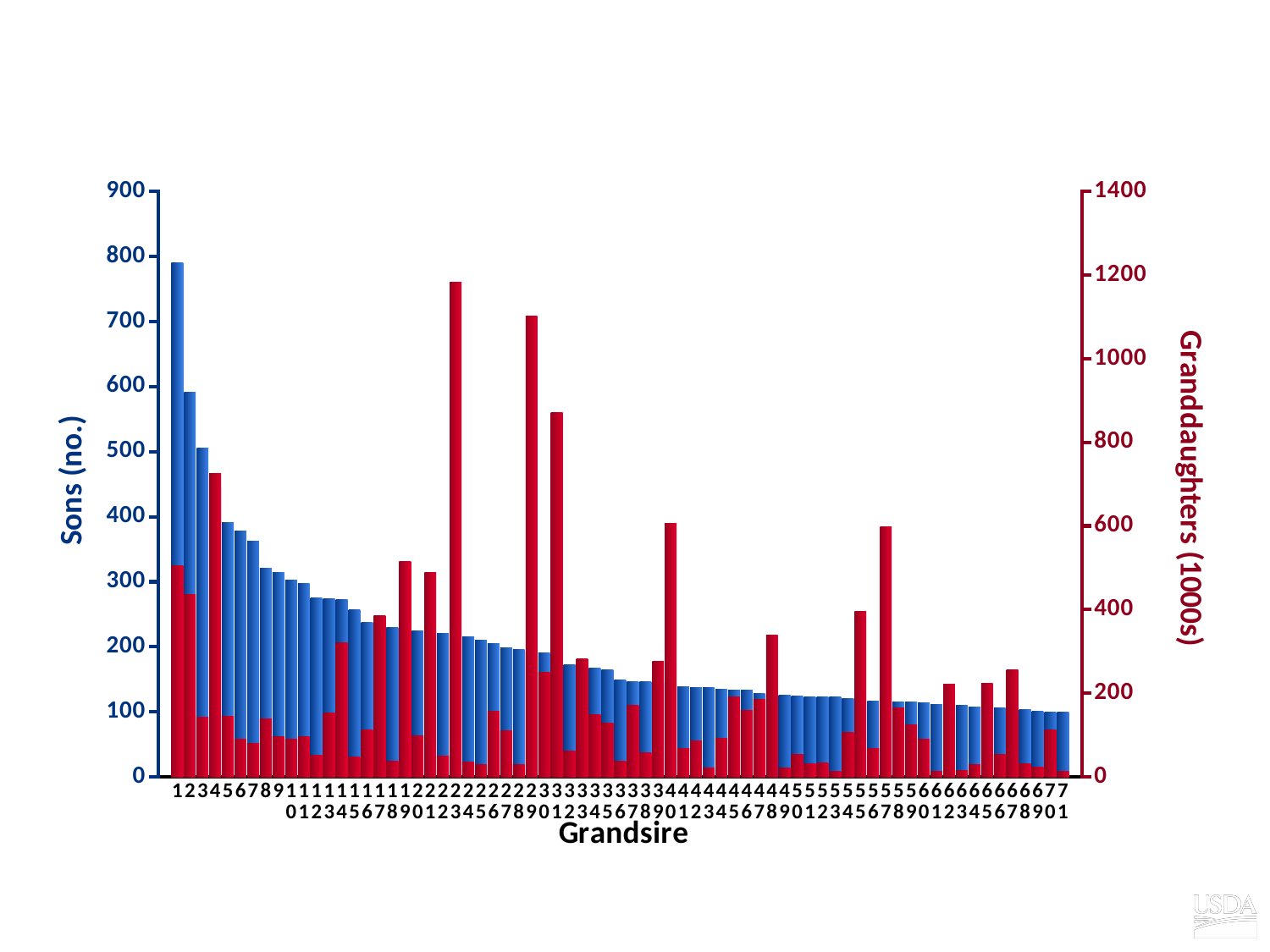
What kind of chart is shown on the slide? bar chart What is the title of the left vertical axis? Sons (no.) What is the title of the right vertical axis? Granddaughters (1000s) How many data series are plotted in the chart? 2 How many grandsires are plotted along the x axis? 71 Which grandsire has more sons, grandsire 1 or grandsire 2? grandsire 1 Is the granddaughters value (1000s) for grandsire 1 greater or less than 400? greater Do the numbers of sons generally rise or fall from left to right along the x axis? fall Which grandsire has the highest number of sons? 1 Is the number of sons for grandsire 71 greater or less than 200? less Is the number of sons for grandsire 2 greater or less than 500? greater